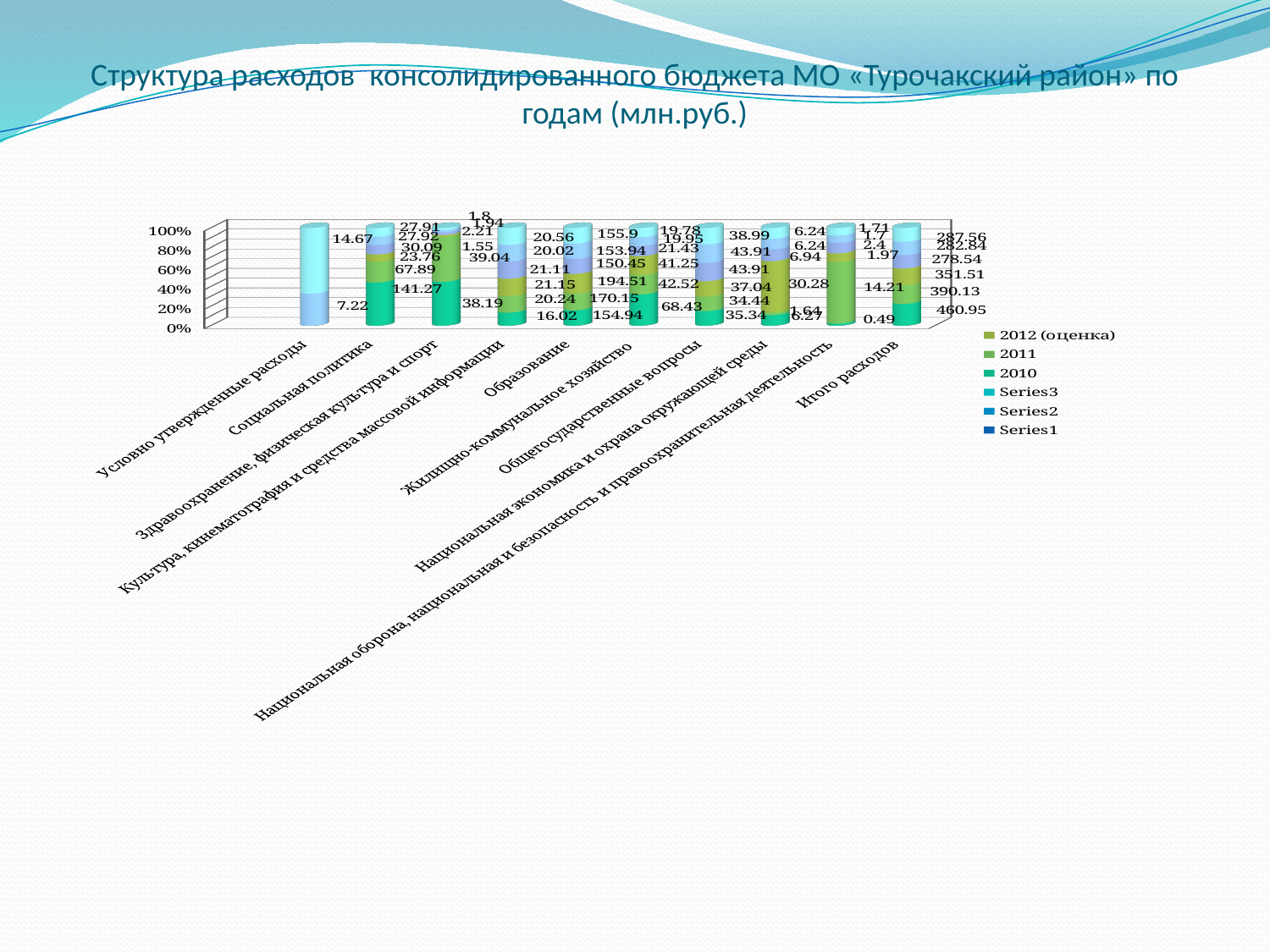
How many categories are shown along the x axis? 10 What is the value of the 2012 (оценка) segment of the 'Образование' bar? 194.51 For 'Образование', which is larger: the 2012 (оценка) value or the 2010 value? 2012 (оценка) What is the value of the 2011 segment of the 'Итого расходов' bar? 390.13 What is the value of the 2012 (оценка) segment of the 'Итого расходов' bar? 351.51 What kind of chart is shown on the slide? Stacked bar chart What is the value of the bottom (2010) segment of the 'Образование' bar? 154.94 What is the value of the bottom (2010) segment of the 'Итого расходов' bar? 460.95 What is the difference between the 2010 value (460.95) and the 2012 (оценка) value (351.51) for 'Итого расходов'? 109.44 Which legend entry is listed first? 2012 (оценка) What is the title of the chart? Структура расходов консолидированного бюджета МО «Турочакский район» по годам (млн.руб.) How many series does the legend list? 6